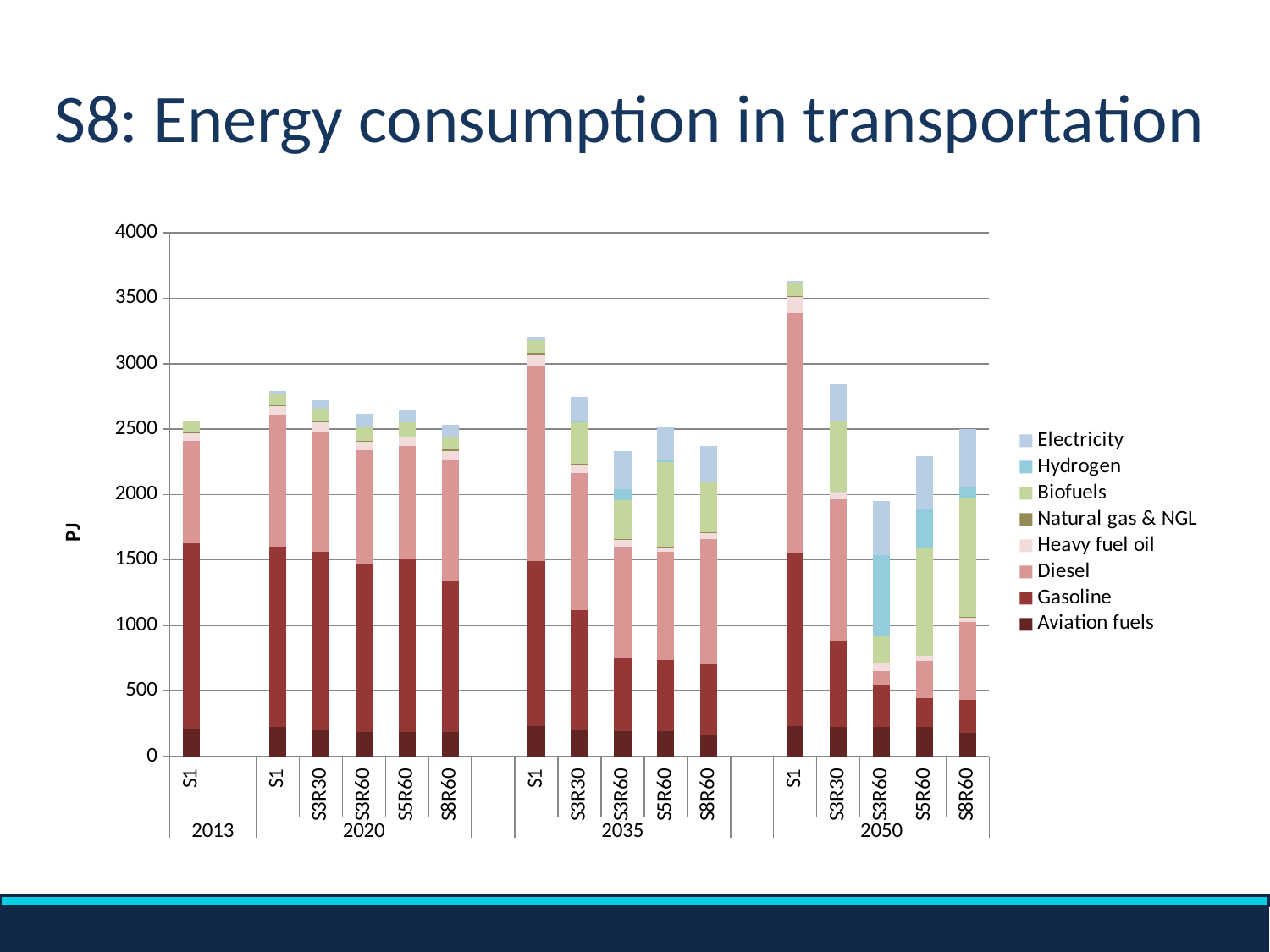
What kind of chart is shown on the slide? Stacked bar chart What unit is shown on the y axis label? PJ How many year groups are shown on the x axis? 4 Which bar has the highest total energy consumption? S1 in 2050 Which has the larger total: S1 in 2035 or S1 in 2050? S1 in 2050 Is the total for S5R60 in 2050 greater or less than 2500 PJ? less Which has the larger total: S3R30 in 2050 or S5R60 in 2050? S3R30 in 2050 Is the total for S1 in 2050 greater or less than 3500 PJ? greater How many bars are plotted in the chart? 16 How many series does the legend list? 8 Which bar has the lowest total energy consumption? S3R60 in 2050 Is the total for S1 in 2035 greater or less than 3000 PJ? greater